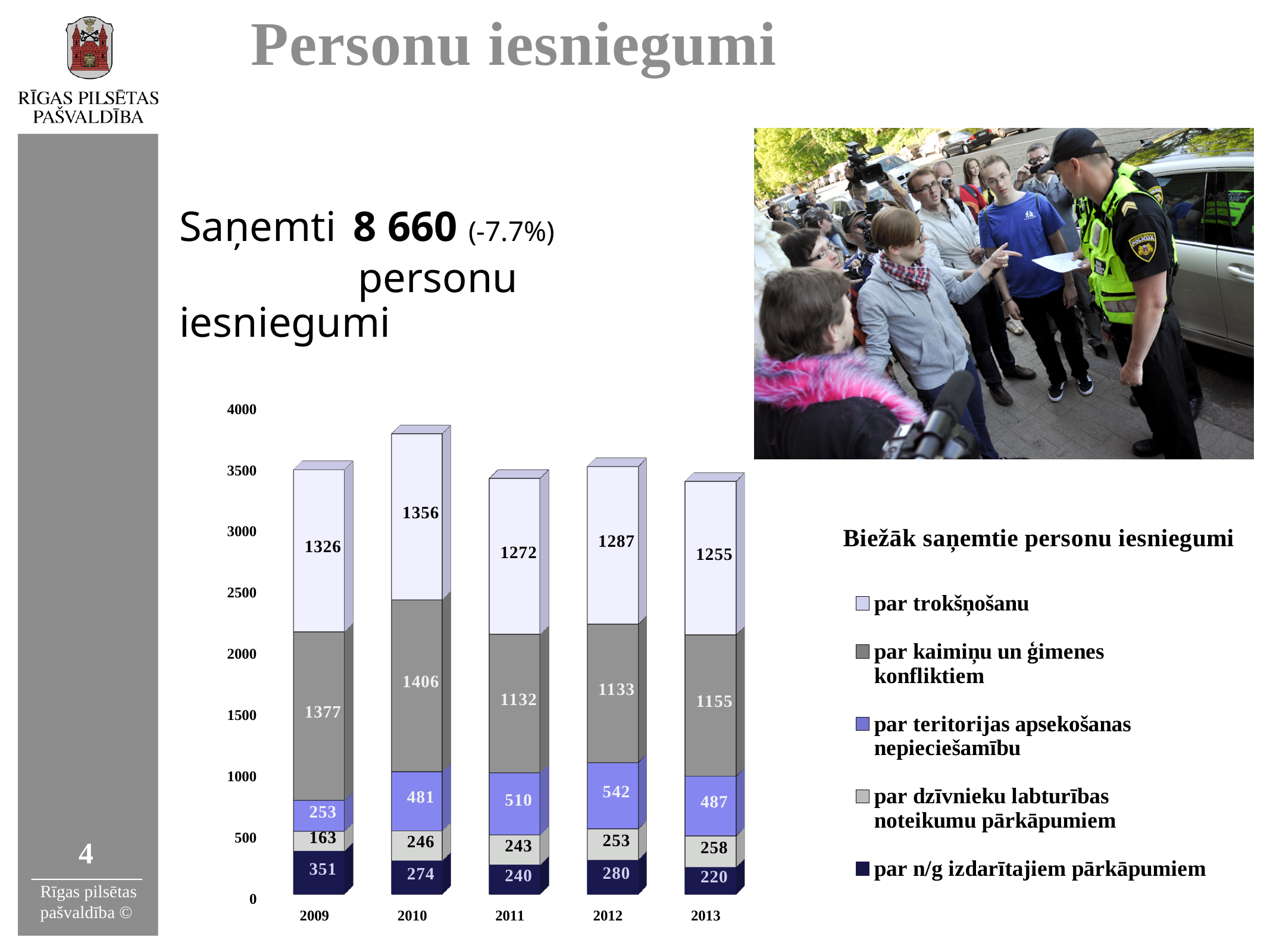
What is the total of the stacked bar for 2010? 3763 In which year is the value for 'par trokšņošanu' the highest? 2010 What is the value for 'par trokšņošanu' in 2010? 1356 What type of chart is shown on the slide? stacked bar chart What is the value for 'par teritorijas apsekošanas nepieciešamību' in 2012? 542 How many years are shown on the x axis of the chart? 5 What is the difference between the 'par kaimiņu un ģimenes konfliktiem' values in 2010 and 2011? 274 How many series does the chart legend list? 5 In which year is the value for 'par n/g izdarītajiem pārkāpumiem' the lowest? 2013 What is the value for 'par n/g izdarītajiem pārkāpumiem' in 2009? 351 Which is larger: the 'par dzīvnieku labturības noteikumu pārkāpumiem' value in 2009 or in 2013? 2013 What is the value for 'par kaimiņu un ģimenes konfliktiem' in 2013? 1155